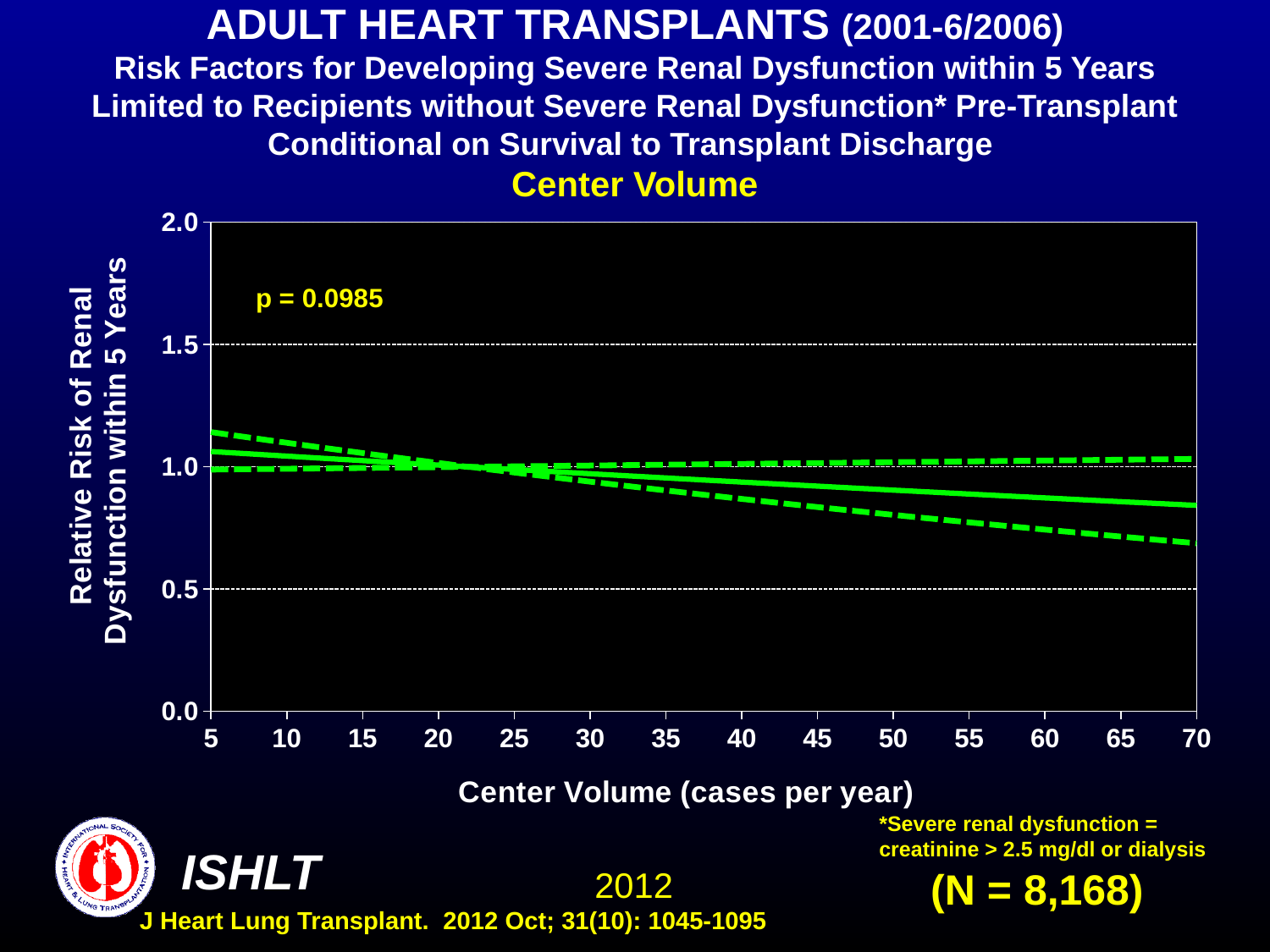
Is the relative risk shown by the solid line at a center volume of 70 cases per year greater or less than 1.0? less Is the relative risk shown by the solid line at a center volume of 70 cases per year greater or less than 0.5? greater Is the lower dashed line at a center volume of 70 cases per year greater or less than 1.0? less What is the lowest center volume shown on the x axis? 5 What is the highest value shown on the y axis? 2.0 Does the solid line for relative risk rise or fall as center volume increases from 5 to 70 cases per year? fall How many lines are plotted on the chart? 3 What kind of chart is shown on the slide? line chart What is the label of the x axis? Center Volume (cases per year)